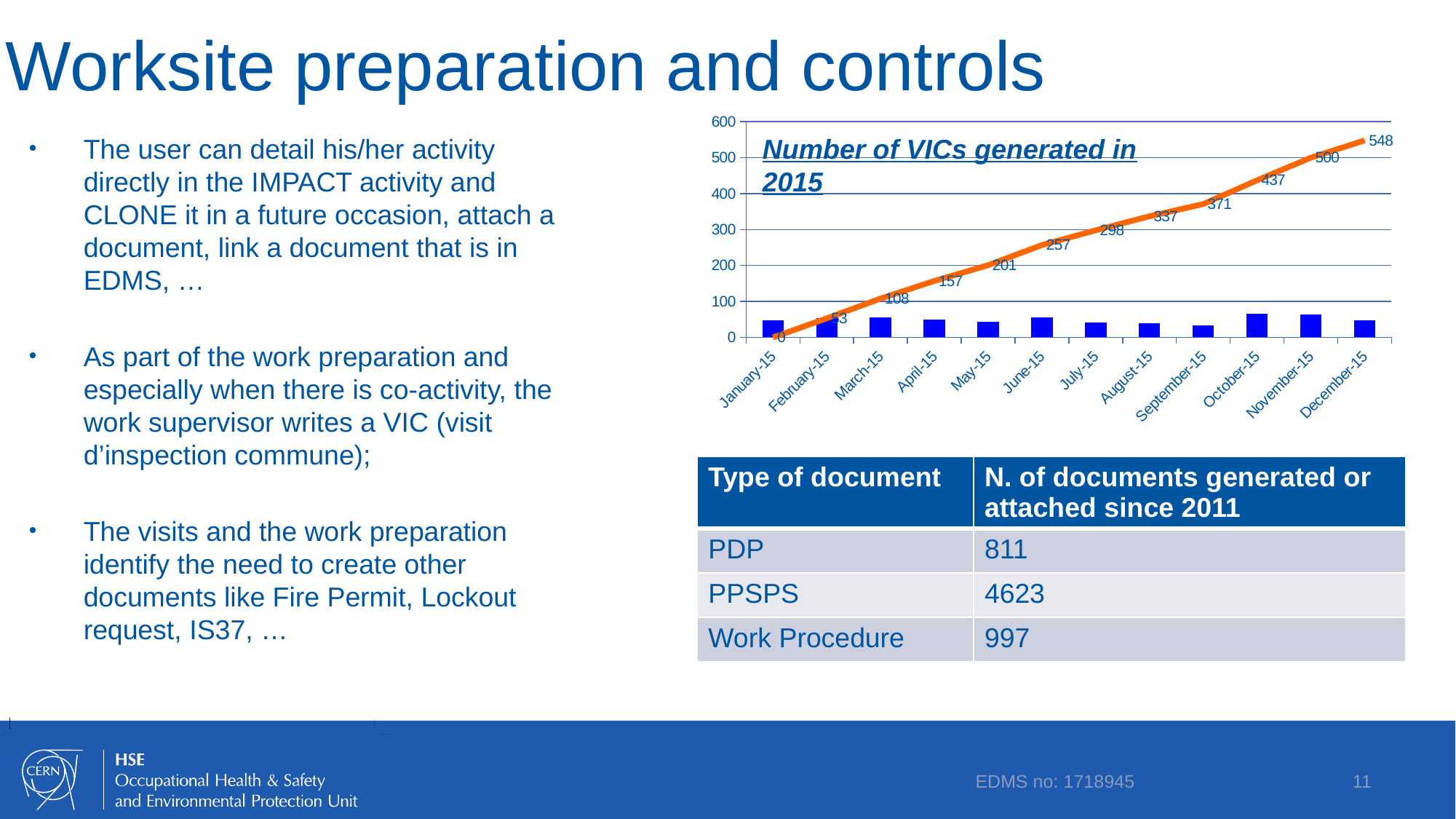
What kind of chart is shown on the slide? Combined bar and line chart How many months are shown on the x axis? 12 Is the bar value for October-15 greater or less than 100? less What is the difference between the line values for December-15 and November-15? 48 What value does the line show for February-15? 53 Does the line rise or fall from January-15 to December-15? Rises Which month has the highest value on the line? December-15 Is the line value for September-15 larger than the line value for August-15? Yes What is the cumulative value shown on the line for December-15? 548 What value does the line show for June-15? 257 What value does the line show for October-15? 437 Which month has the lowest value on the line? January-15